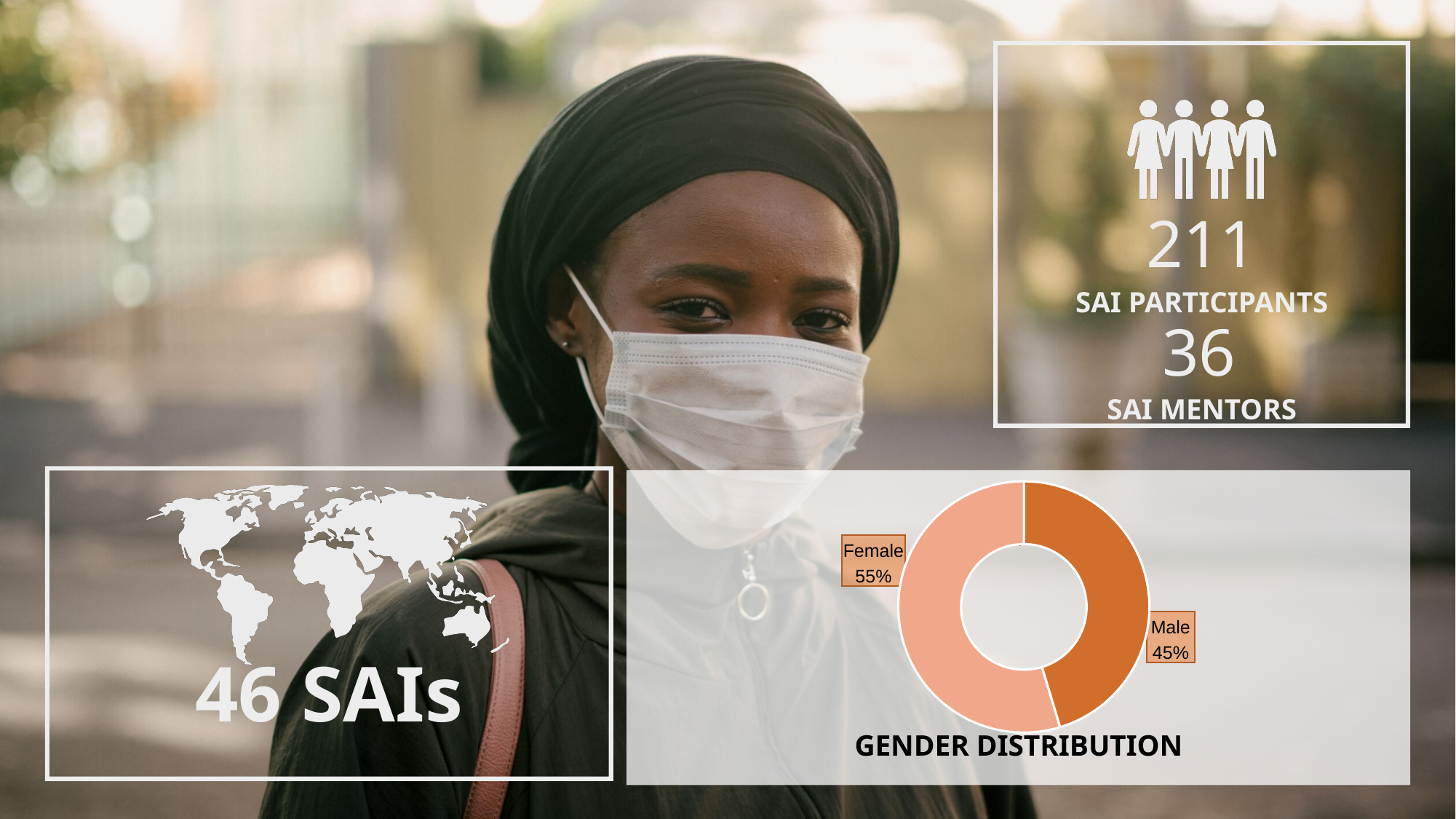
Which category has the larger share in the Gender Distribution chart? Female What is the title of the chart on the slide? GENDER DISTRIBUTION Is the Female share larger or smaller than the Male share in the Gender Distribution chart? larger What kind of chart is the Gender Distribution chart? Doughnut (pie) chart What share of the Gender Distribution chart is Male? 45% What is the difference in percentage points between the Female and Male shares in the Gender Distribution chart? 10 percentage points How many categories are shown in the Gender Distribution chart? 2 What share of the Gender Distribution chart is Female? 55% Which category has the smaller share in the Gender Distribution chart? Male Which category in the Gender Distribution chart is shown in the darker orange colour? Male